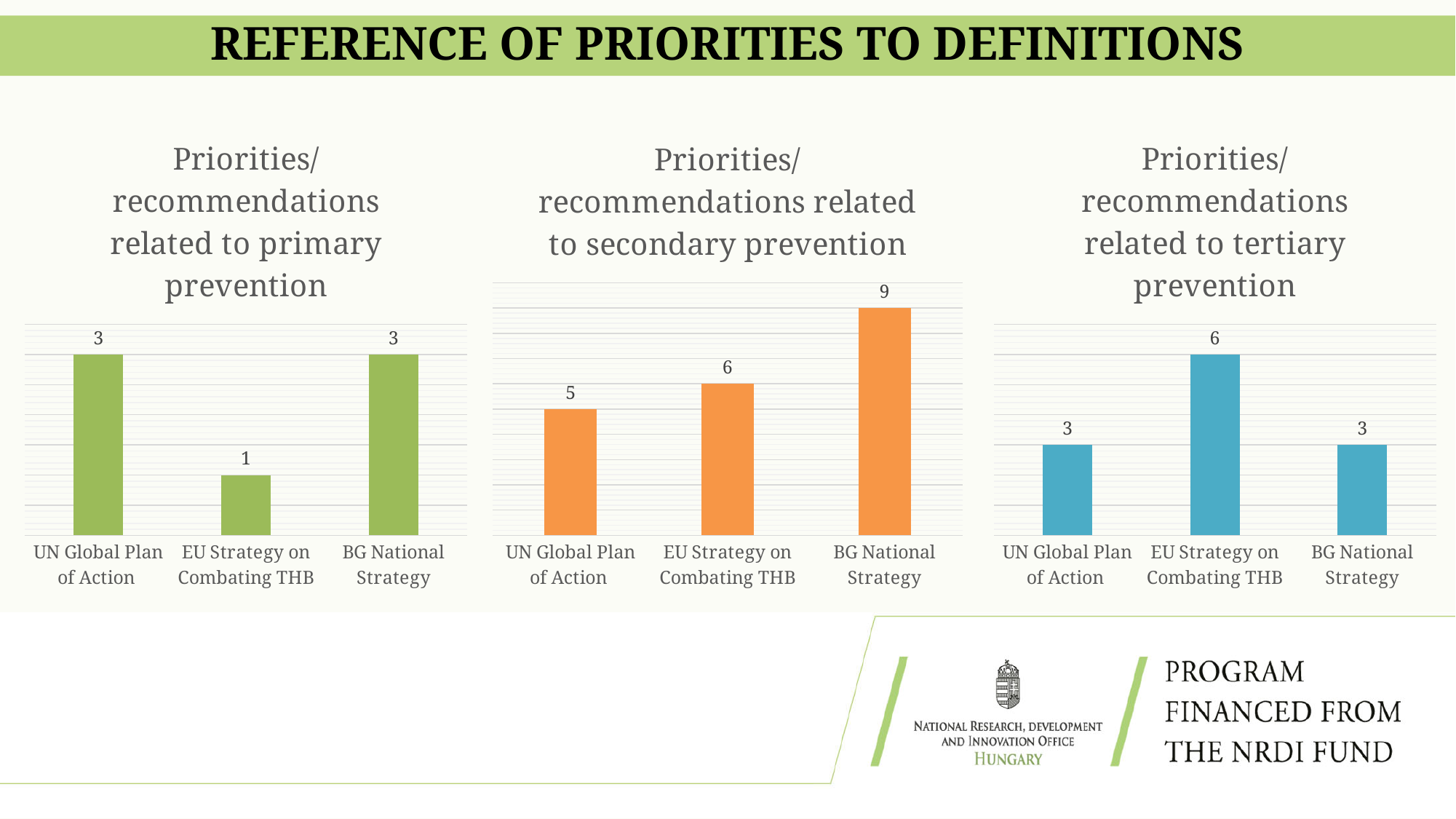
How many categories does the primary prevention chart show? 3 What colour are the bars in the tertiary prevention chart? Blue In the primary prevention chart, what is the value for EU Strategy on Combating THB? 1 In the tertiary prevention chart, what is the value for EU Strategy on Combating THB? 6 In the secondary prevention chart, do the values rise or fall from left to right? Rise In the tertiary prevention chart, what is the difference between EU Strategy on Combating THB and BG National Strategy? 3 In the secondary prevention chart, which is larger: UN Global Plan of Action or EU Strategy on Combating THB? EU Strategy on Combating THB In the secondary prevention chart, what is the difference between BG National Strategy and UN Global Plan of Action? 4 In the primary prevention chart, which category has the lowest value? EU Strategy on Combating THB In the secondary prevention chart, what is the value for BG National Strategy? 9 What kind of chart is the secondary prevention chart? Bar chart In the secondary prevention chart, which category has the highest value? BG National Strategy